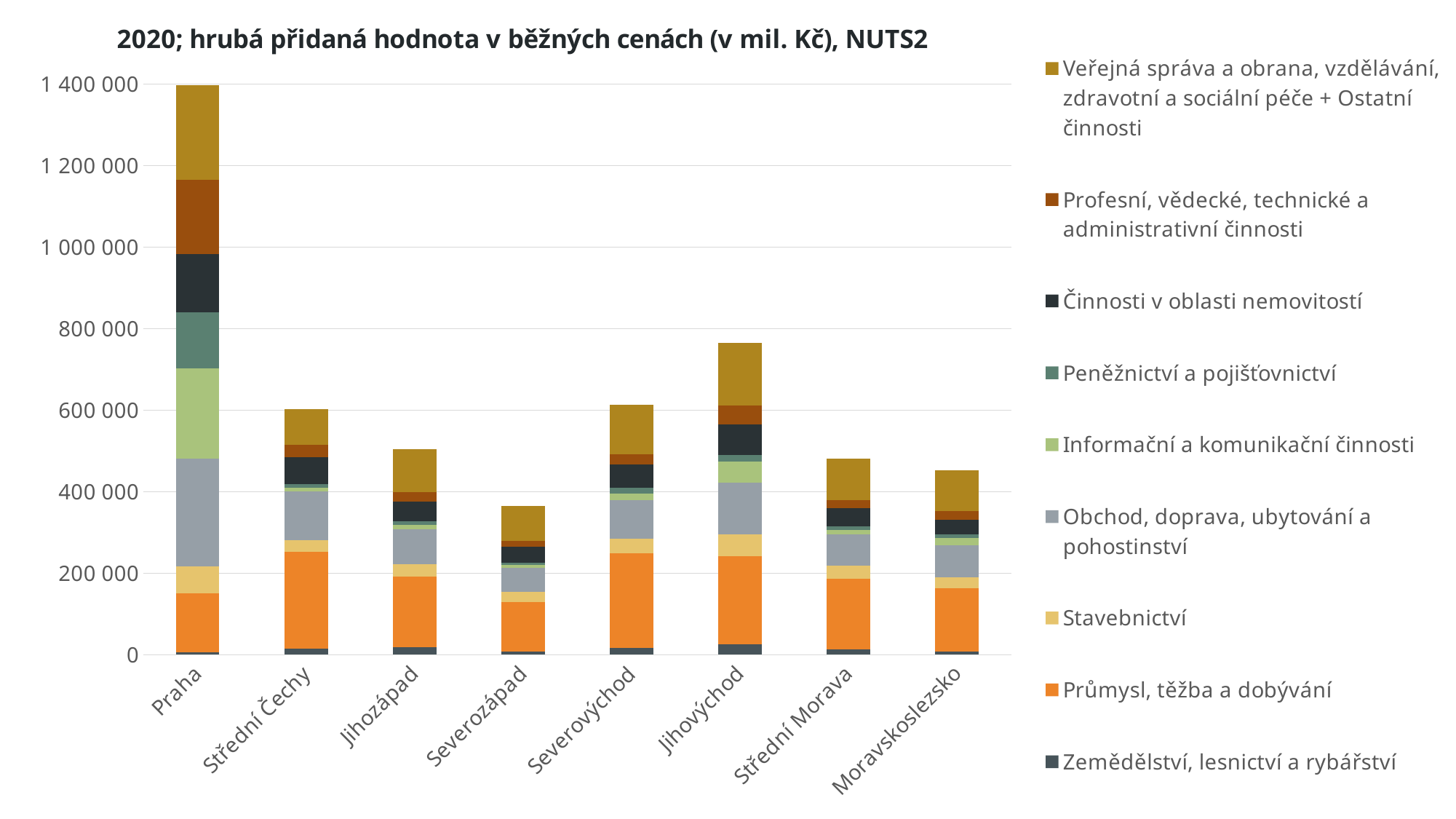
Which region has the highest total gross value added? Praha Which region has the lowest total gross value added? Severozápad What kind of chart is shown on the slide? stacked bar chart What is the title of the chart? 2020; hrubá přidaná hodnota v běžných cenách (v mil. Kč), NUTS2 Is the total value for Praha greater or less than 1 200 000? greater How many series does the legend list? 9 Which has the larger total gross value added, Jihovýchod or Střední Morava? Jihovýchod Is the total value for Severozápad greater or less than 400 000? less Which has the larger total gross value added, Severozápad or Jihozápad? Jihozápad Is the total value for Moravskoslezsko greater or less than 400 000? greater How many regions (categories) are shown on the x axis? 8